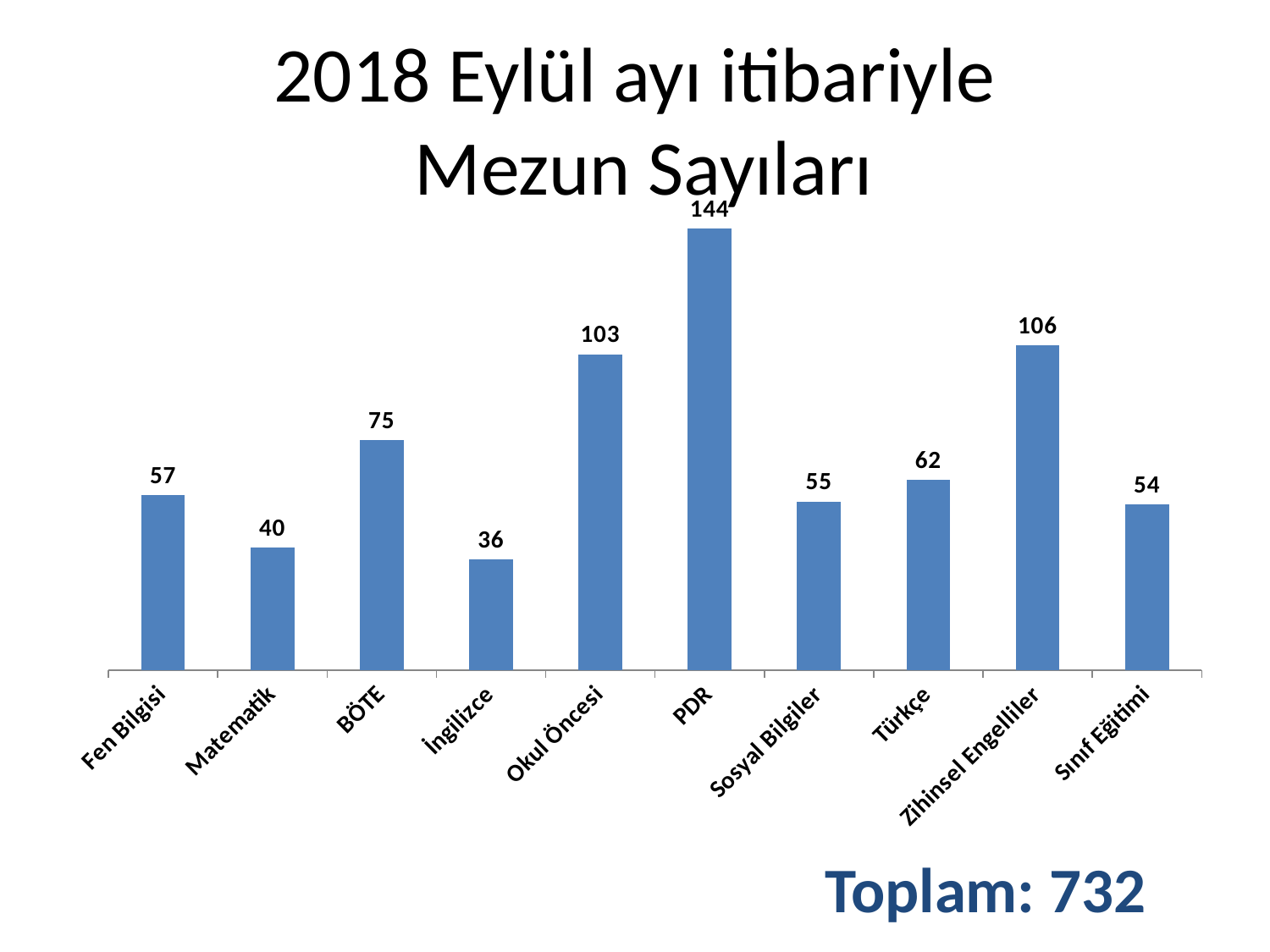
What is the value for Zihinsel Engelliler? 106 Which category has the highest value? PDR What is the difference between the values for PDR and Zihinsel Engelliler? 38 How many categories are shown on the x axis? 10 Which is larger, the value for Türkçe or the value for Sosyal Bilgiler? Türkçe What is the value for PDR? 144 What is the value for Okul Öncesi? 103 What kind of chart is shown on the slide? Bar chart What is the difference between the values for BÖTE and Matematik? 35 Which category has the lowest value? İngilizce What is the value for İngilizce? 36 What total is printed below the chart? Toplam: 732